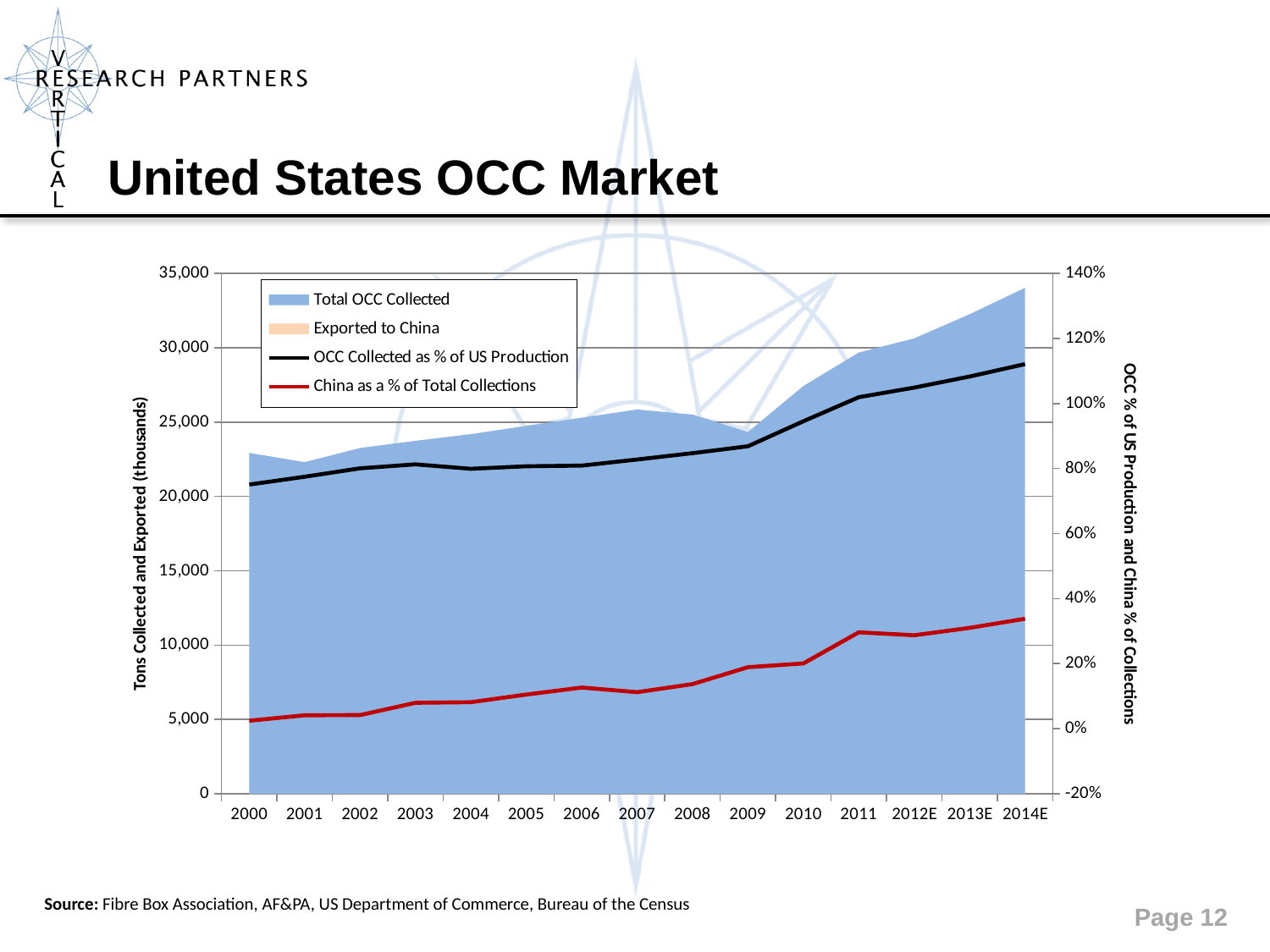
How many years are shown along the x axis? 15 In which year is Total OCC Collected highest? 2014E Does OCC Collected as % of US Production generally rise or fall from 2000 to 2014E? rise How many series does the legend list? 4 Is the value for Total OCC Collected in 2000 greater or less than 25,000? less Is the value for China as a % of Total Collections in 2000 greater or less than 20%? less Is the value for OCC Collected as % of US Production in 2014E greater or less than 100%? greater Which is larger, China as a % of Total Collections in 2011 or in 2009? 2011 What is the title of the left vertical axis? Tons Collected and Exported (thousands) What kind of chart is shown on the slide? Area and line chart In which year is China as a % of Total Collections highest? 2014E